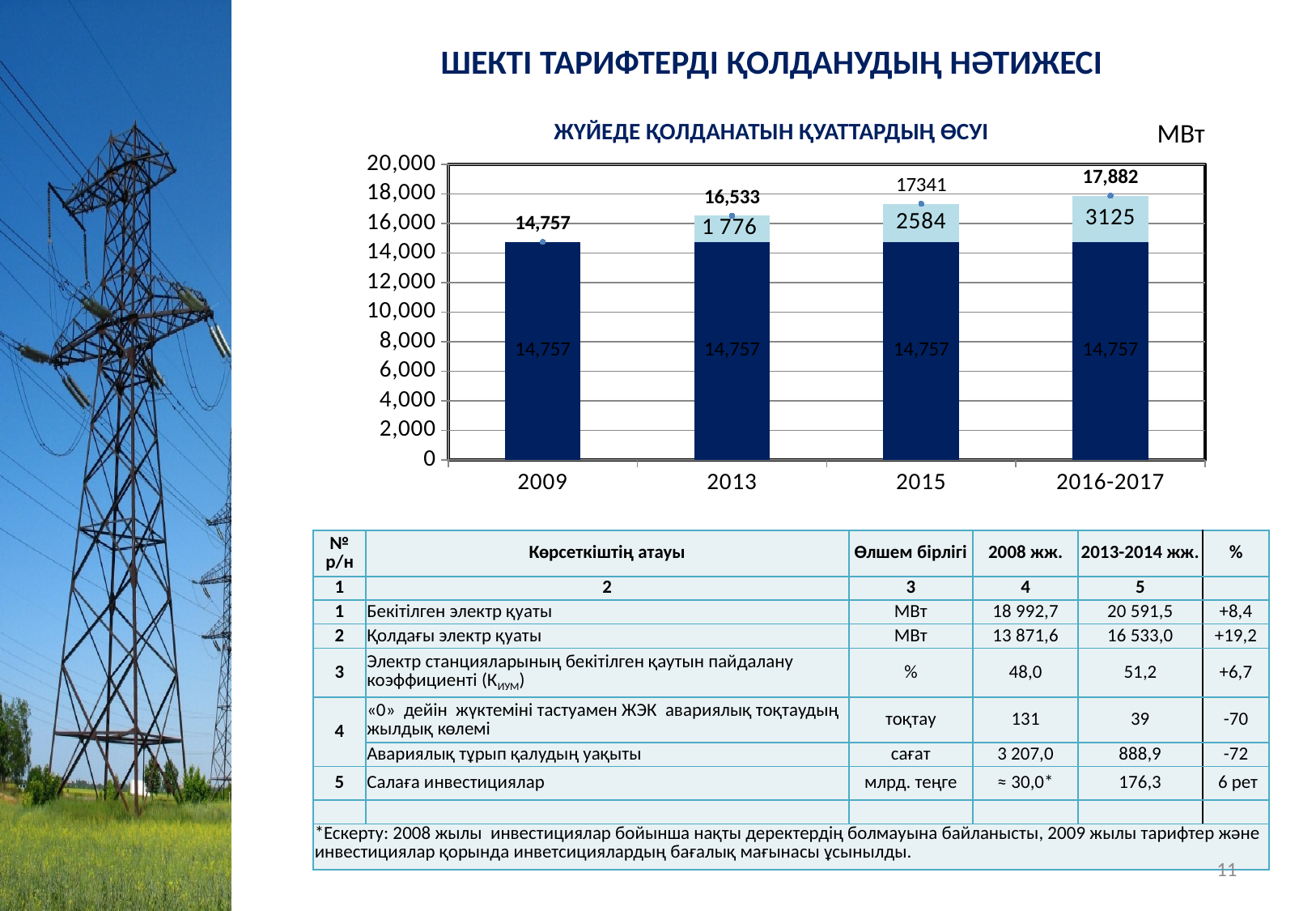
What is the total value labelled above the bar for 2009? 14,757 What is the total value labelled above the bar for 2013? 16,533 What is the value of the light blue top segment of the bar for 2015? 2584 What is the total value labelled above the bar for 2016-2017? 17,882 Which category has the lowest total value? 2009 Which category has the highest total value? 2016-2017 What unit is shown next to the chart title? МВт What type of chart is shown on the slide? stacked bar chart What is the value of the light blue top segment of the bar for 2016-2017? 3125 Do the total values rise or fall from 2009 to 2016-2017? rise What is the total value labelled above the bar for 2015? 17341 How many categories are shown on the x axis of the chart? 4